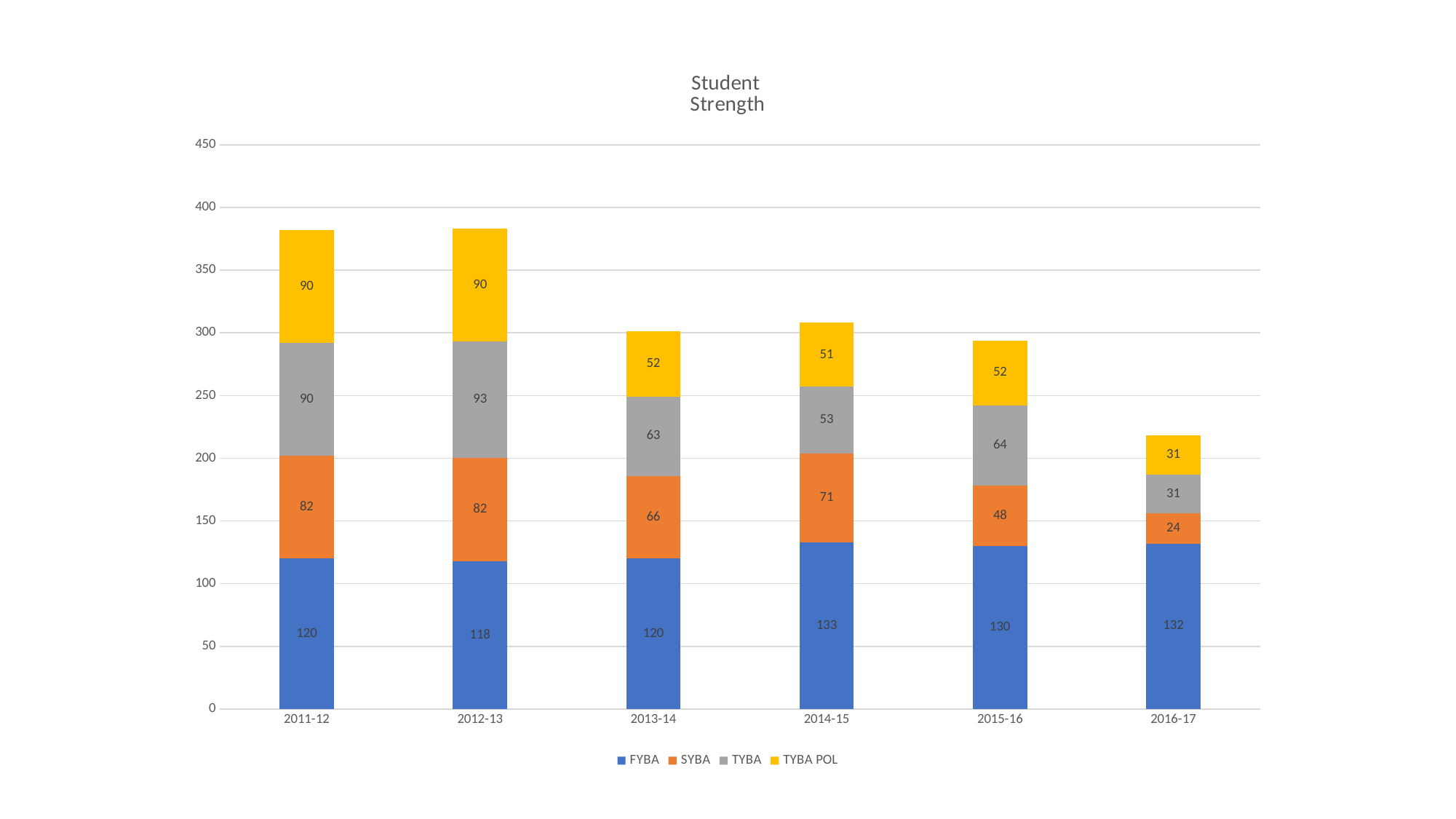
What is the TYBA POL value for 2012-13? 90 What is the FYBA value for 2014-15? 133 How many academic years are shown on the x axis? 6 What is the difference between the SYBA values for 2011-12 and 2015-16? 34 Which year has the highest FYBA value? 2014-15 How many series does the legend list? 4 What is the title of the chart? Student Strength Which year has the lowest TYBA value? 2016-17 Which is larger, the TYBA value for 2013-14 or the TYBA value for 2015-16? 2015-16 What is the total student strength for 2016-17 (sum of all four segments)? 218 What type of chart is shown on the slide? Stacked bar chart What is the SYBA value for 2016-17? 24